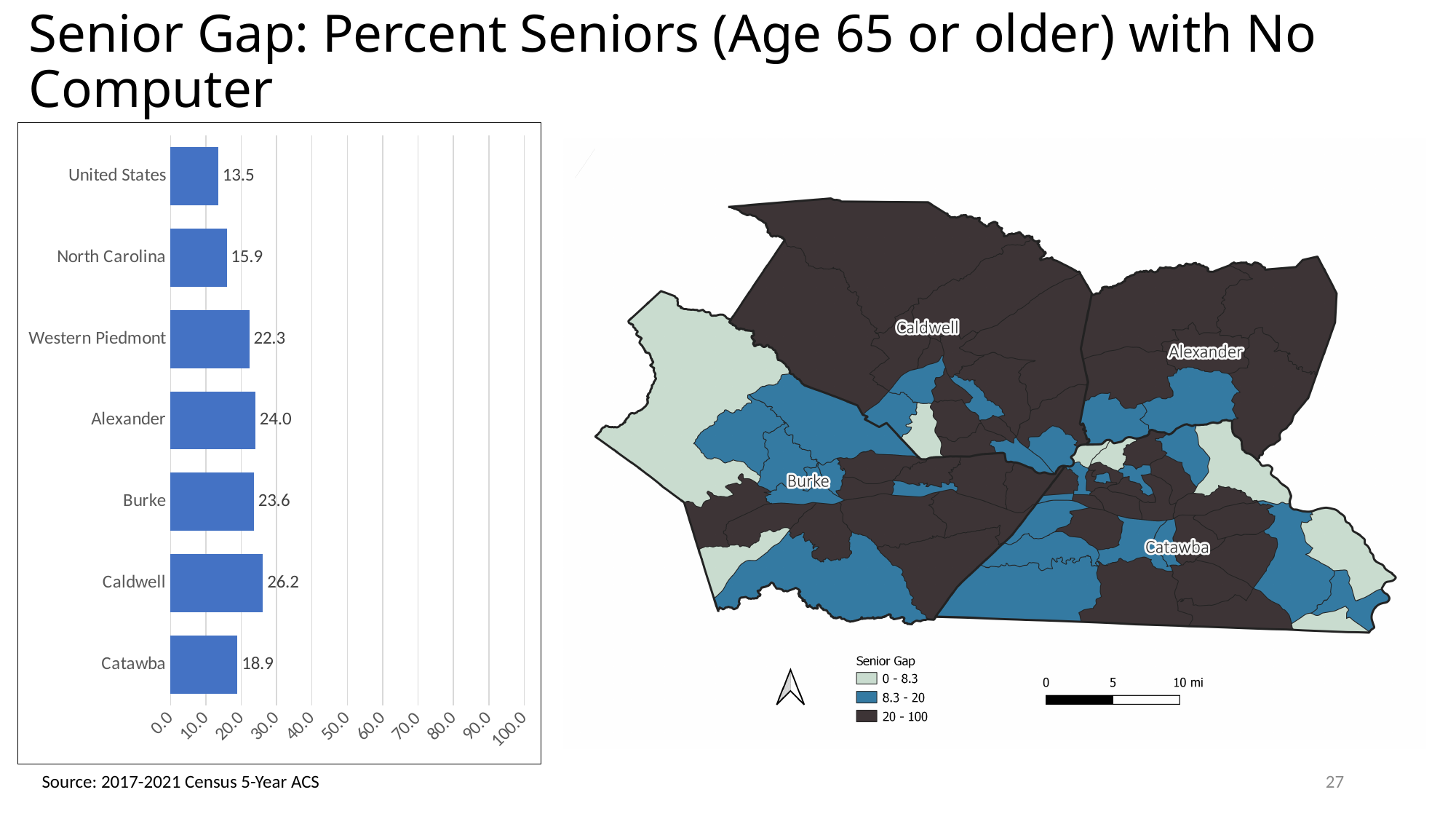
How many categories are shown in the bar chart? 7 What is the highest value shown on the x axis of the bar chart? 100.0 What is the value for United States in the bar chart? 13.5 Which category has the lowest value in the bar chart? United States What is the difference between the values for North Carolina and United States in the bar chart? 2.4 Which is larger in the bar chart, the value for Alexander or the value for Burke? Alexander What is the value for Western Piedmont in the bar chart? 22.3 Which category has the highest value in the bar chart? Caldwell Is the value for North Carolina in the bar chart greater or less than 20.0? less What kind of chart is shown on the left of the slide? bar chart What is the value for Caldwell in the bar chart? 26.2 What is the difference between the values for Caldwell and Catawba in the bar chart? 7.3